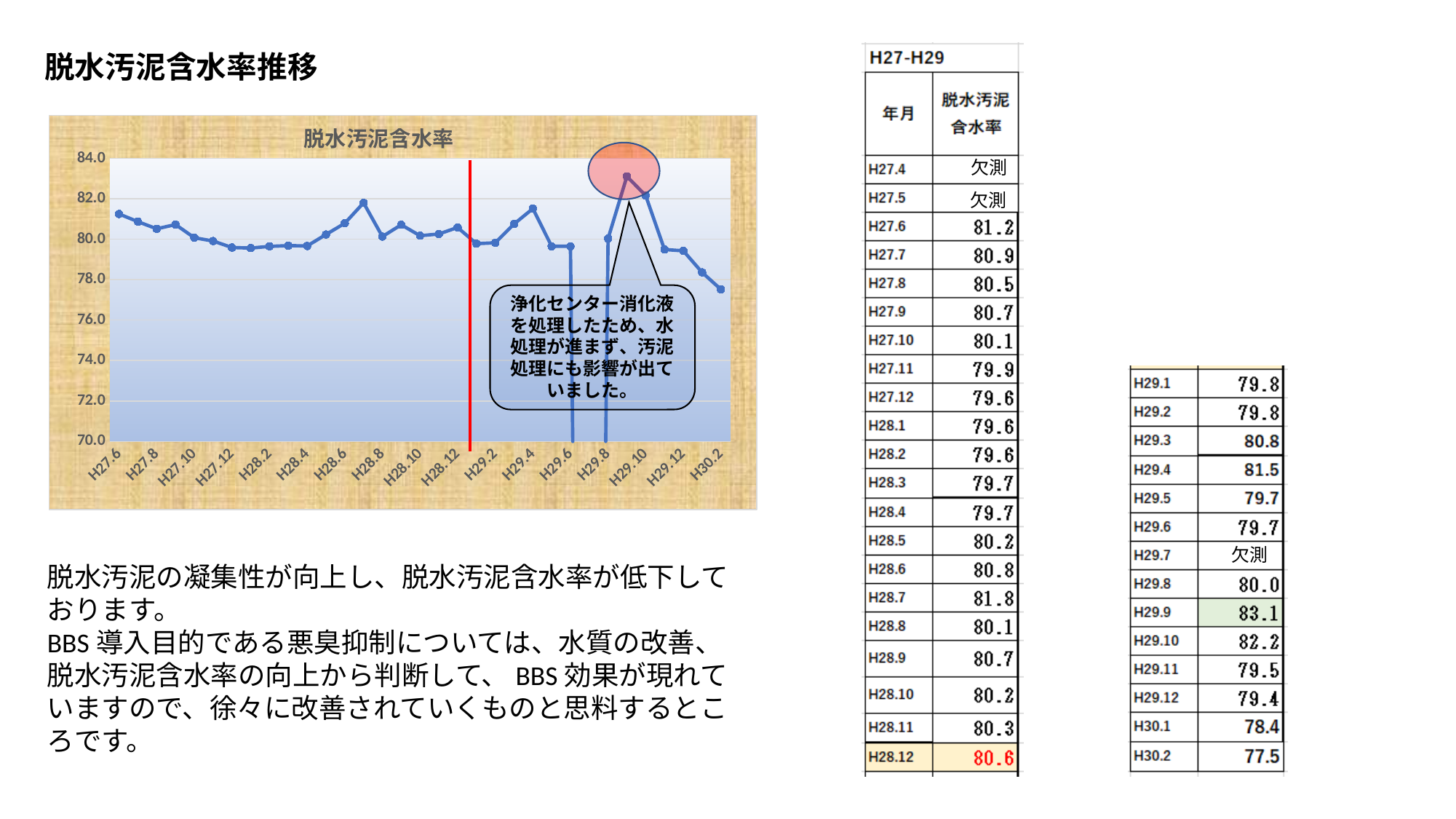
Which is larger, the value for H27.6 or the value for H30.1? H27.6 Is the value for H30.2 greater or less than 78.0? less What is the title of the chart? 脱水汚泥含水率 Which month has the highest 脱水汚泥含水率 value? H29.9 What is the 脱水汚泥含水率 value for H27.6? 81.2 What is the 脱水汚泥含水率 value for H30.2? 77.5 What is the difference between the values for H29.9 and H30.2? 5.6 Is the value for H29.9 greater or less than 82.0? greater Do the values rise or fall from H29.9 to H30.2? fall What kind of chart is shown on the slide? line chart Which month has the lowest 脱水汚泥含水率 value? H30.2 What is the 脱水汚泥含水率 value for H28.7? 81.8